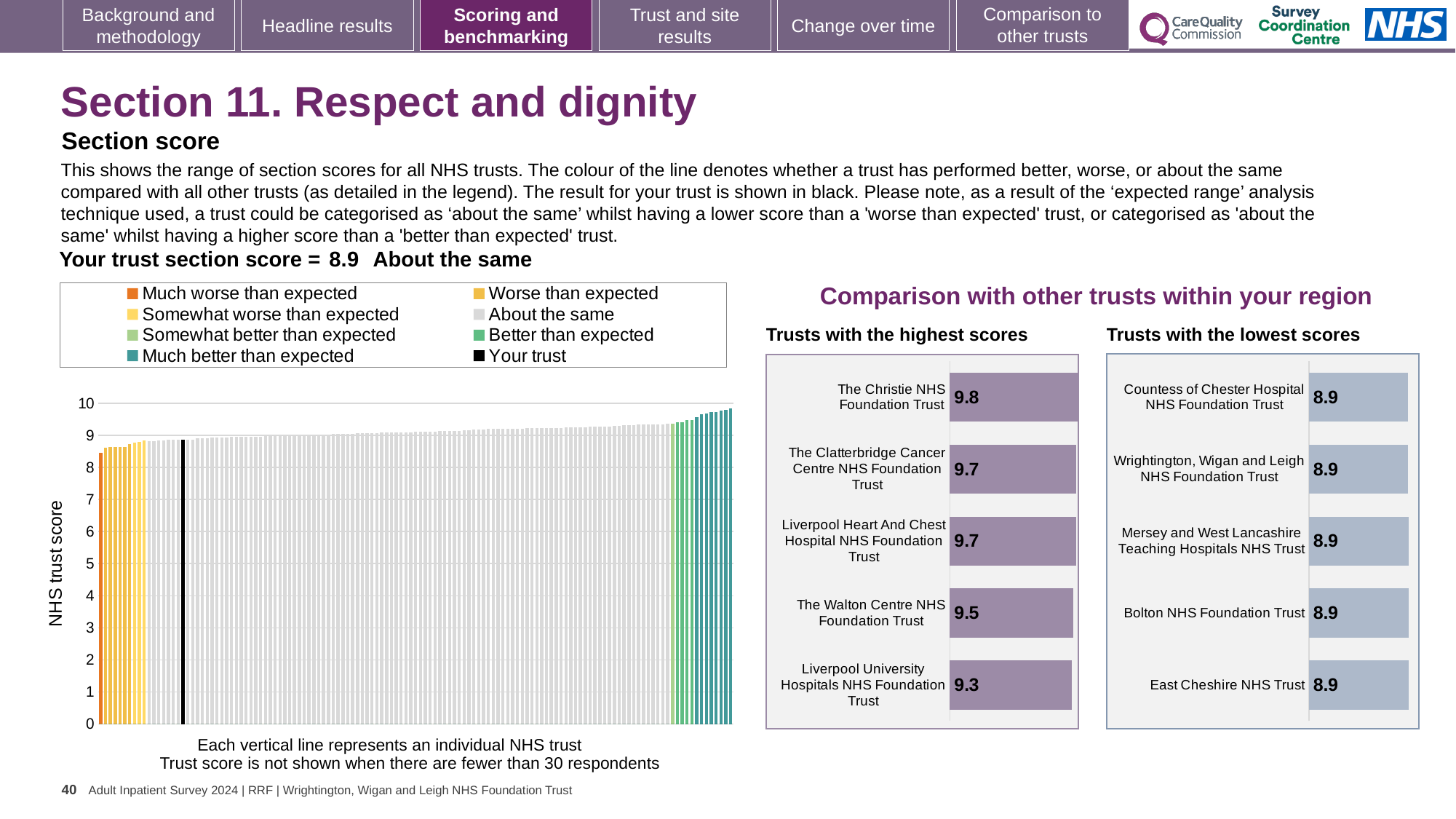
In the 'Trusts with the lowest scores' chart, what is the score for Bolton NHS Foundation Trust? 8.9 In the 'Trusts with the highest scores' chart, what is the score for The Christie NHS Foundation Trust? 9.8 In the large chart on the left showing all NHS trusts, what kind of chart is it? Bar chart In the 'Trusts with the highest scores' chart, what is the difference between the scores of The Christie NHS Foundation Trust and Liverpool University Hospitals NHS Foundation Trust? 0.5 In the 'Trusts with the lowest scores' chart, what is the score for East Cheshire NHS Trust? 8.9 How many trusts are shown in the 'Trusts with the highest scores' chart? 5 In the 'Trusts with the highest scores' chart, what is the score for The Walton Centre NHS Foundation Trust? 9.5 In the 'Trusts with the highest scores' chart, which has the larger score: The Clatterbridge Cancer Centre NHS Foundation Trust or The Walton Centre NHS Foundation Trust? The Clatterbridge Cancer Centre NHS Foundation Trust How many trusts are shown in the 'Trusts with the lowest scores' chart? 5 In the large chart on the left showing all NHS trusts, do the trust scores rise or fall from left to right? Rise In the 'Trusts with the highest scores' chart, which trust has the lowest score? Liverpool University Hospitals NHS Foundation Trust In the 'Trusts with the highest scores' chart, which trust has the highest score? The Christie NHS Foundation Trust